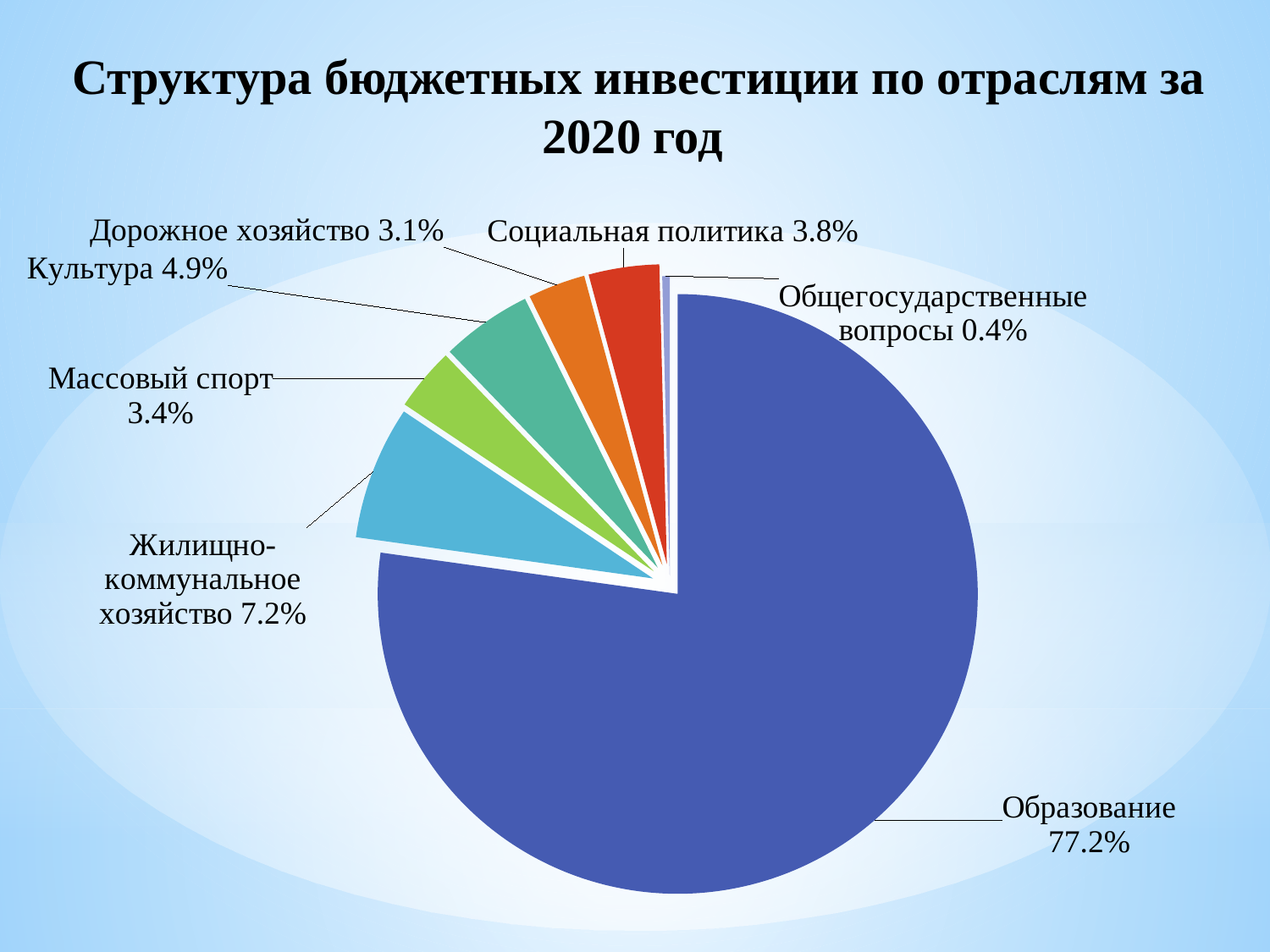
What is the value for Культура? 4.9% What share of the pie does Образование have? 77.2% How many slices does the pie chart have? 7 What is the value for Жилищно-коммунальное хозяйство? 7.2% What is the value for Общегосударственные вопросы? 0.4% Which category has the largest slice of the pie? Образование What kind of chart is shown on the slide? pie chart Which is larger, Социальная политика or Массовый спорт? Социальная политика Which category has the smallest slice of the pie? Общегосударственные вопросы What colour is the Образование slice? blue What is the difference between Жилищно-коммунальное хозяйство and Дорожное хозяйство? 4.1% What is the title of the chart on the slide? Структура бюджетных инвестиции по отраслям за 2020 год